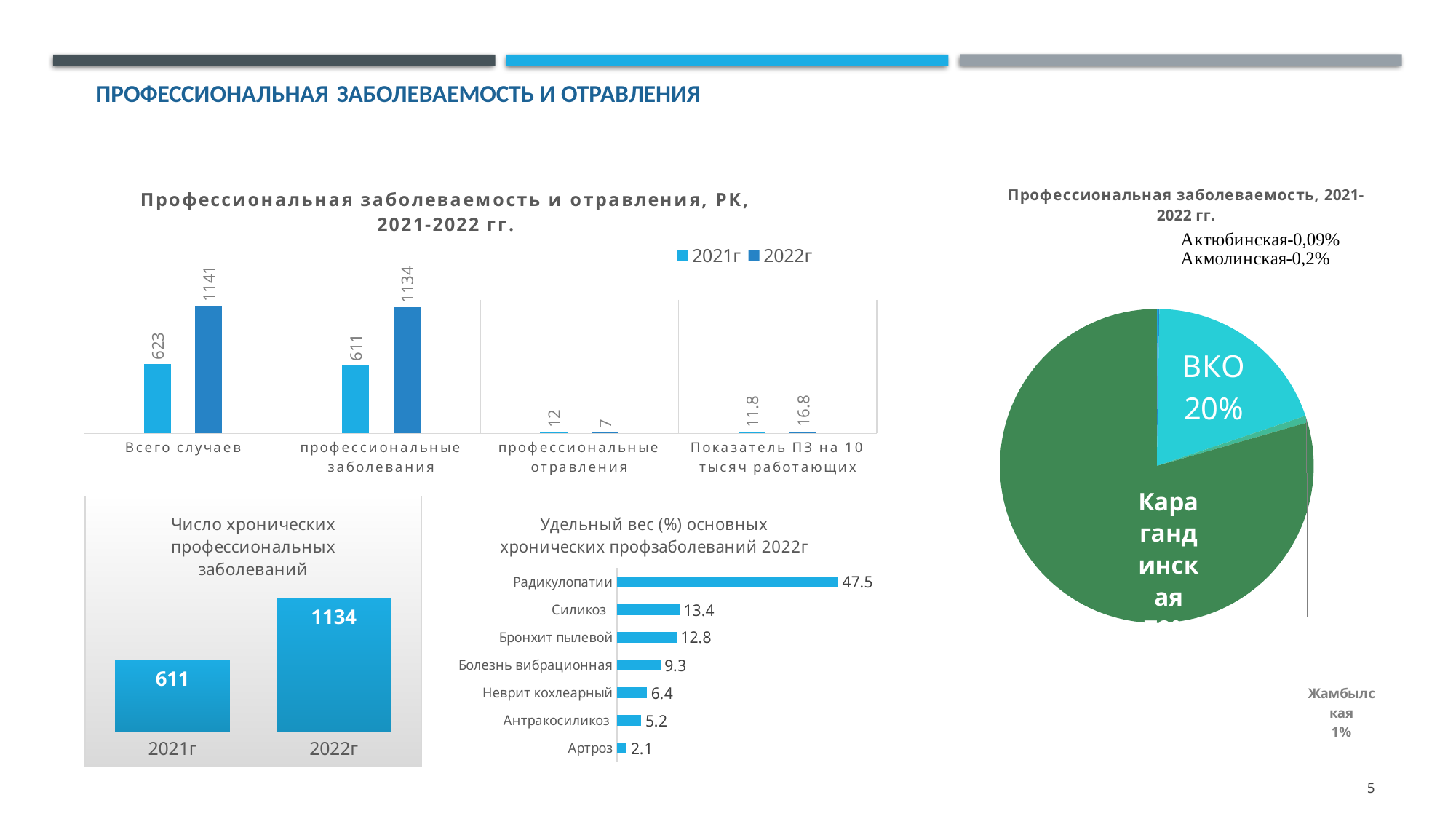
In the chart 'Профессиональная заболеваемость и отравления, РК, 2021-2022 гг.', how many series does the legend list? 2 In the chart 'Удельный вес (%) основных хронических профзаболеваний 2022г', which category has the highest value? Радикулопатии How many categories are shown in the chart 'Удельный вес (%) основных хронических профзаболеваний 2022г'? 7 In the chart 'Профессиональная заболеваемость и отравления, РК, 2021-2022 гг.', what is the value for 'Всего случаев' in 2022г? 1141 In the chart 'Профессиональная заболеваемость и отравления, РК, 2021-2022 гг.', what is the value for 'профессиональные отравления' in 2021г? 12 In the chart 'Число хронических профессиональных заболеваний', do the values rise or fall from 2021г to 2022г? rise In the pie chart 'Профессиональная заболеваемость, 2021-2022 гг.', what share does ВКО have? 20% In the chart 'Профессиональная заболеваемость и отравления, РК, 2021-2022 гг.', which year has the larger value for 'Показатель ПЗ на 10 тысяч работающих'? 2022г In the chart 'Удельный вес (%) основных хронических профзаболеваний 2022г', what is the value for 'Бронхит пылевой'? 12.8 In the chart 'Число хронических профессиональных заболеваний', what is the value for 2021г? 611 In the chart 'Удельный вес (%) основных хронических профзаболеваний 2022г', which category has the lowest value? Артроз In the chart 'Профессиональная заболеваемость и отравления, РК, 2021-2022 гг.', what is the difference between the 2022г and 2021г values for 'Всего случаев'? 518